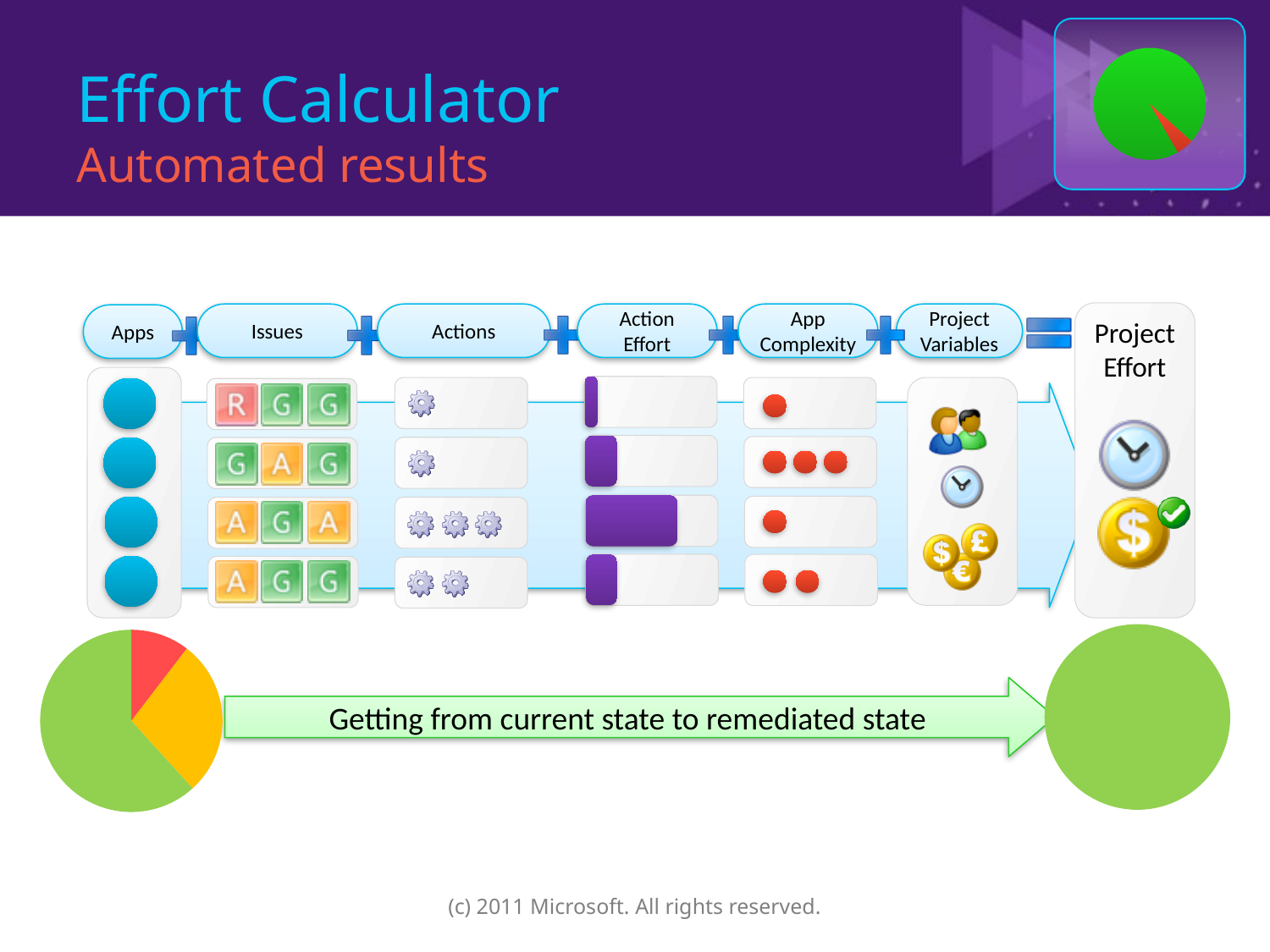
What kind of chart is shown at the bottom right of the slide? pie chart In the bottom-left pie chart, which is larger, the green slice or the orange slice? green How many slices does the bottom-right pie chart have? 1 In the bottom-left pie chart, which colour slice is the smallest? red How many pie charts are shown on the slide? 3 What colour is the single slice of the bottom-right pie chart? green What kind of chart is shown at the bottom left of the slide? pie chart How many slices does the bottom-left pie chart have? 3 In the bottom-left pie chart, which colour slice is the largest? green In the bottom-left pie chart, which is larger, the orange slice or the red slice? orange